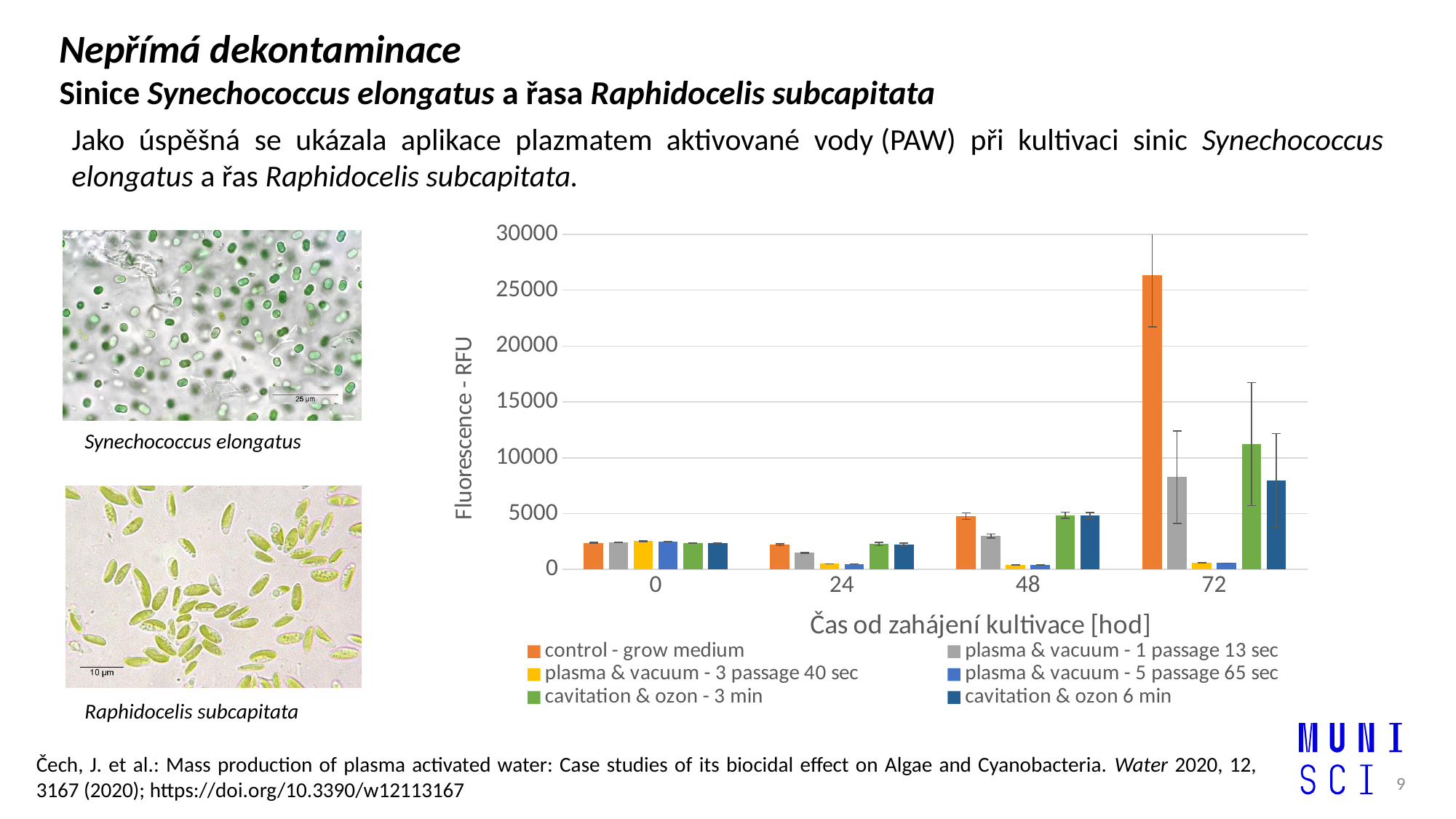
How many time points (categories) are shown on the x axis of the chart? 4 At 72 hours, which series has the highest fluorescence? control - grow medium At 48 hours, which is larger: control - grow medium or plasma & vacuum - 1 passage 13 sec? control - grow medium Is the value for plasma & vacuum - 1 passage 13 sec at 72 hours greater or less than 5000? greater Is the value for cavitation & ozon - 3 min at 72 hours greater or less than 15000? less Is the value for control - grow medium at 72 hours greater or less than 20000? greater How many series does the chart legend list? 6 At 72 hours, which is larger: cavitation & ozon - 3 min or cavitation & ozon 6 min? cavitation & ozon - 3 min What is the label of the y axis of the chart? Fluorescence - RFU Does the control - grow medium series rise or fall from 0 to 72 hours? rises What kind of chart is shown on the slide? bar chart What is the label of the x axis of the chart? Čas od zahájení kultivace [hod]